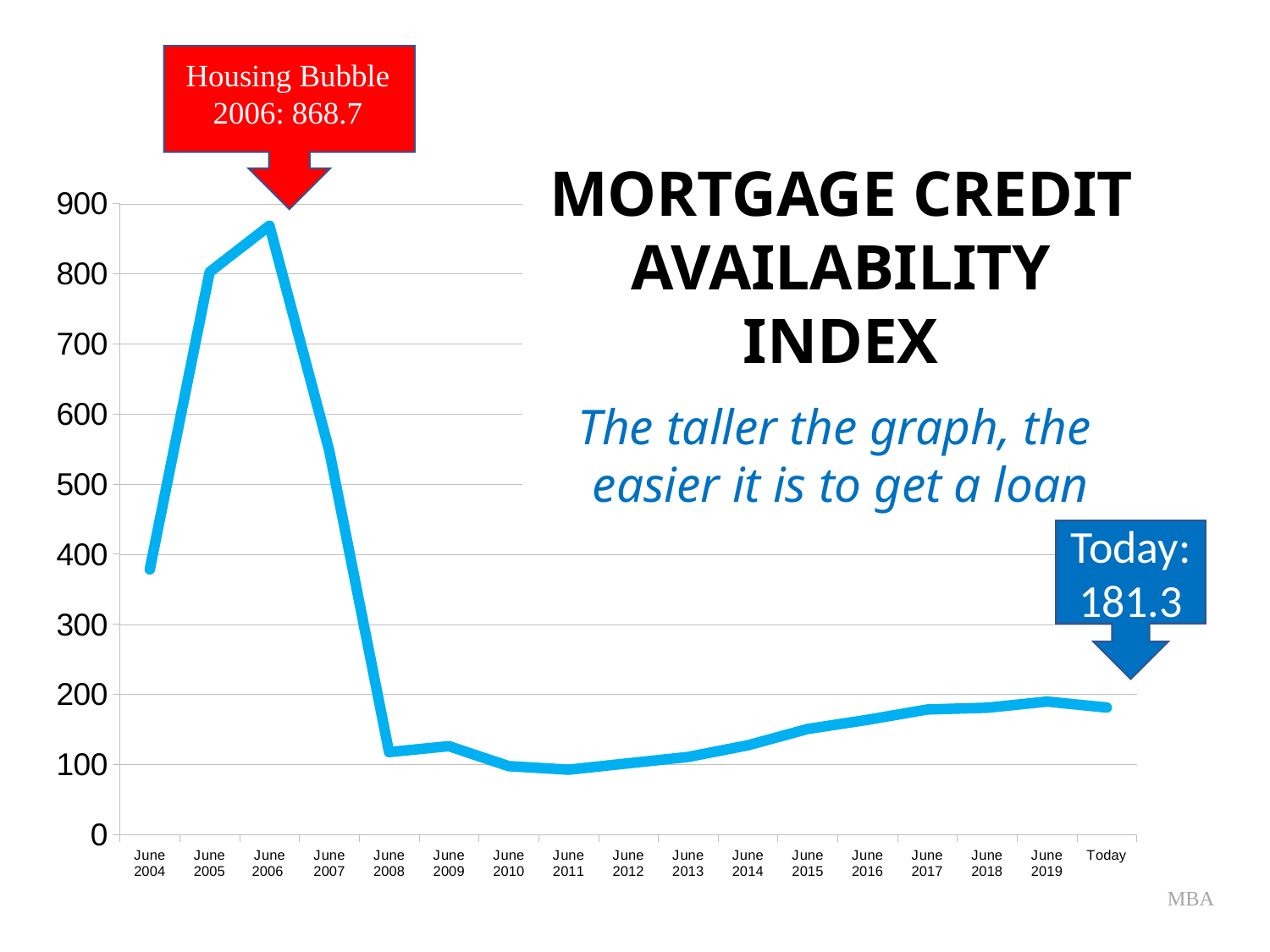
Is the value for June 2008 greater or less than 200? less Is the value for June 2004 greater or less than 300? greater How many points are plotted along the x axis? 17 What is the difference between the June 2006 value (868.7) and the Today value (181.3)? 687.4 Which point on the x axis has the highest value? June 2006 Which is larger, the value for June 2005 or the value for June 2008? June 2005 What is the value of the Mortgage Credit Availability Index for Today, as shown in the callout? 181.3 Do the values rise or fall from June 2011 to June 2019? rise What is the value of the Mortgage Credit Availability Index for June 2006, as shown in the callout? 868.7 Is the value for June 2005 greater or less than 700? greater What is the title of the chart? Mortgage Credit Availability Index What kind of chart is shown on the slide? line chart